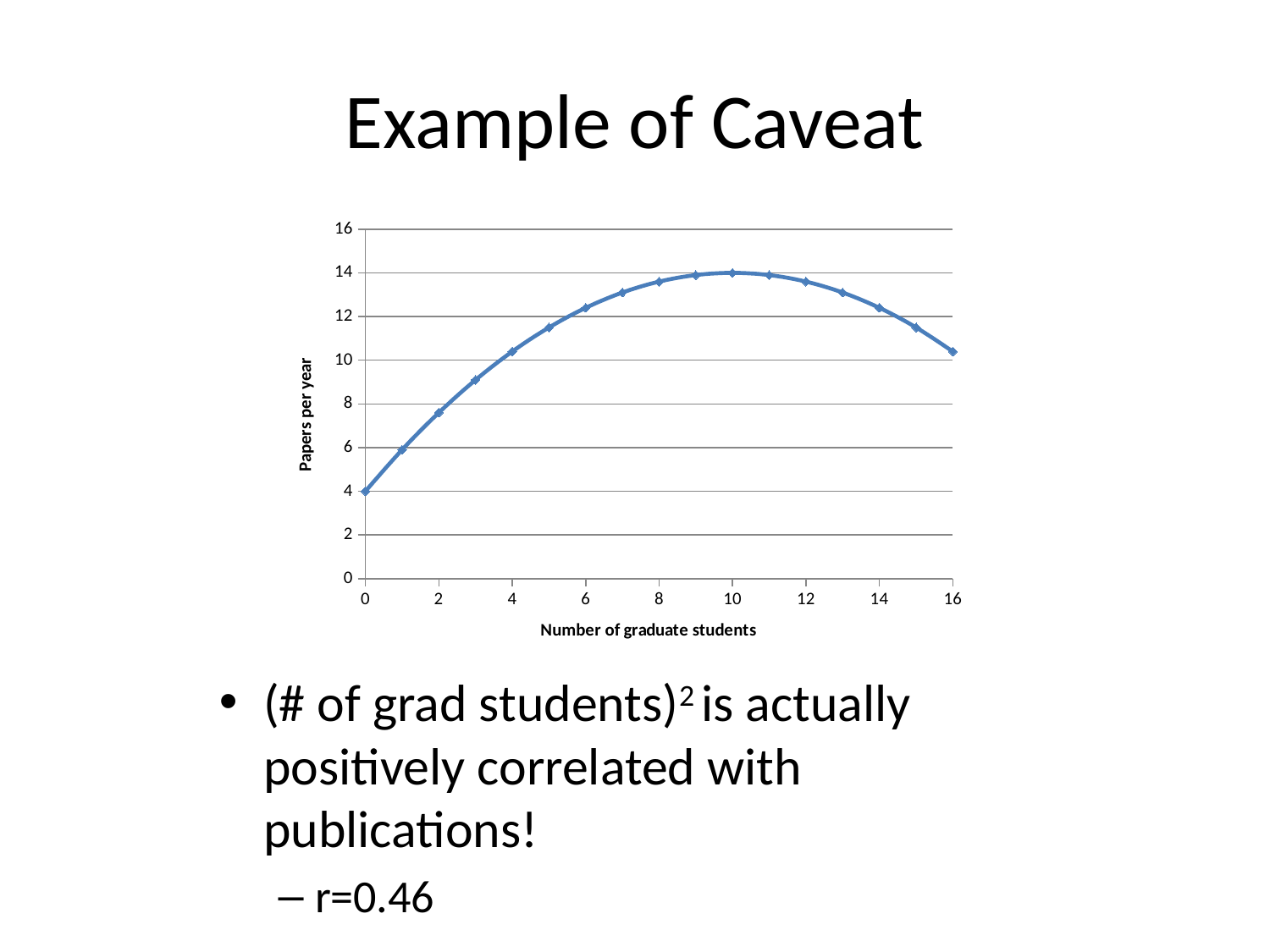
How many data points are plotted on the line? 17 What is the value of Papers per year when the number of graduate students is 0? 4 What kind of chart is shown on the slide? line chart Is the value for 5 graduate students greater or less than 10? greater What is the value of Papers per year when the number of graduate students is 10? 14 What is the difference in Papers per year between 10 graduate students and 0 graduate students? 10 At which number of graduate students is Papers per year lowest? 0 At which number of graduate students is Papers per year highest? 10 Which has more Papers per year: 2 graduate students or 14 graduate students? 14 graduate students How does Papers per year change as the number of graduate students increases from 0 to 16? rises until 10, then falls Is the value for 8 graduate students greater or less than 12? greater Is the value for 3 graduate students greater or less than 8? greater